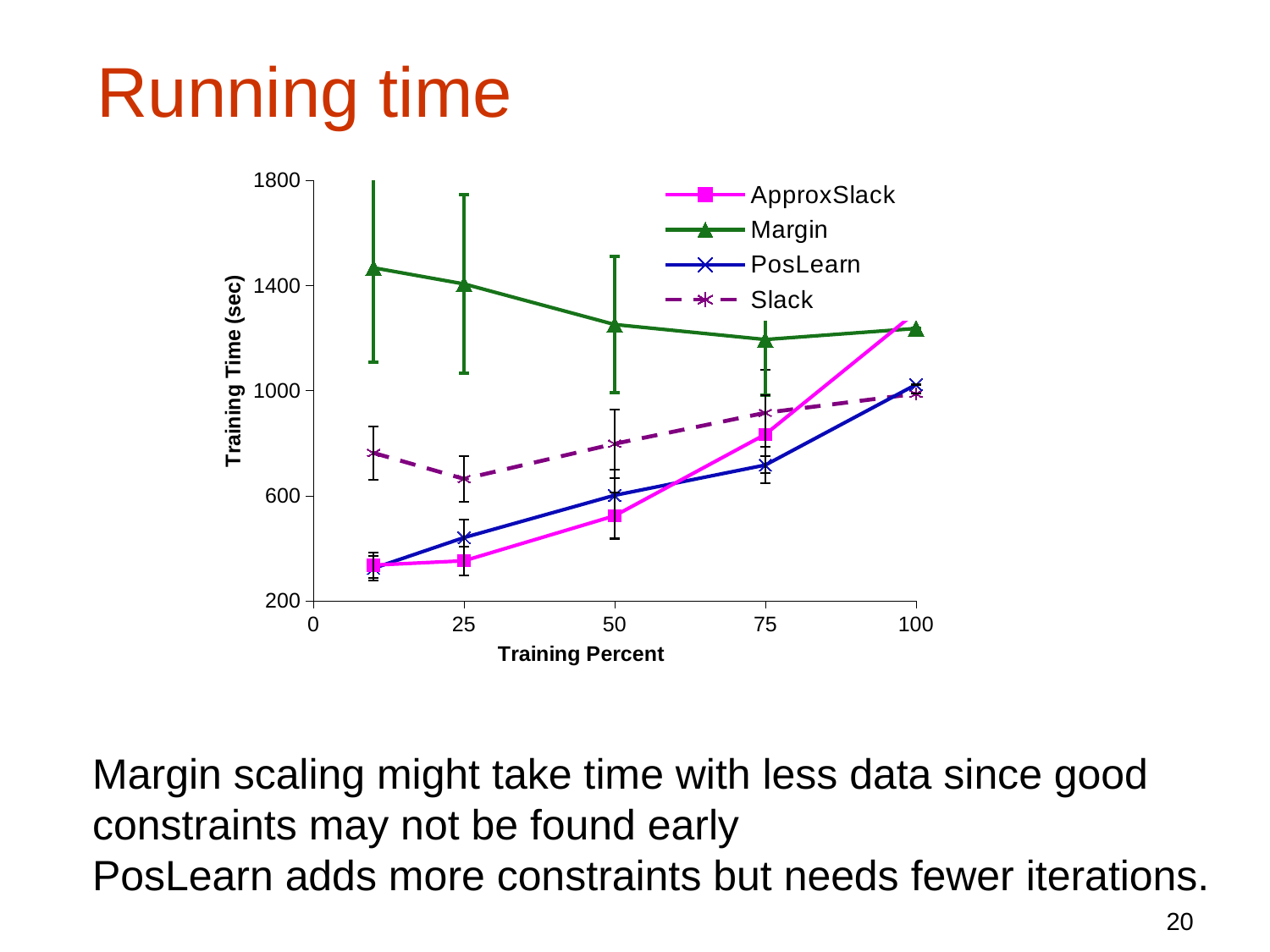
What type of chart is shown on the slide? line chart At a training percent of 75, which has the larger training time, Slack or PosLearn? Slack At a training percent of 100, which has the larger training time, ApproxSlack or PosLearn? ApproxSlack Is the training time for ApproxSlack at a training percent of 50 greater or less than 600? less Is the training time for Margin at a training percent of 10 greater or less than 1400? greater Which series has the highest training time at a training percent of 25? Margin Does the training time for PosLearn rise or fall as training percent increases? rise How many series does the legend list? 4 How many data points are plotted for each series? 5 What is the title of the x axis? Training Percent What is the title of the y axis? Training Time (sec) Is the training time for Slack at a training percent of 25 greater or less than 600? greater